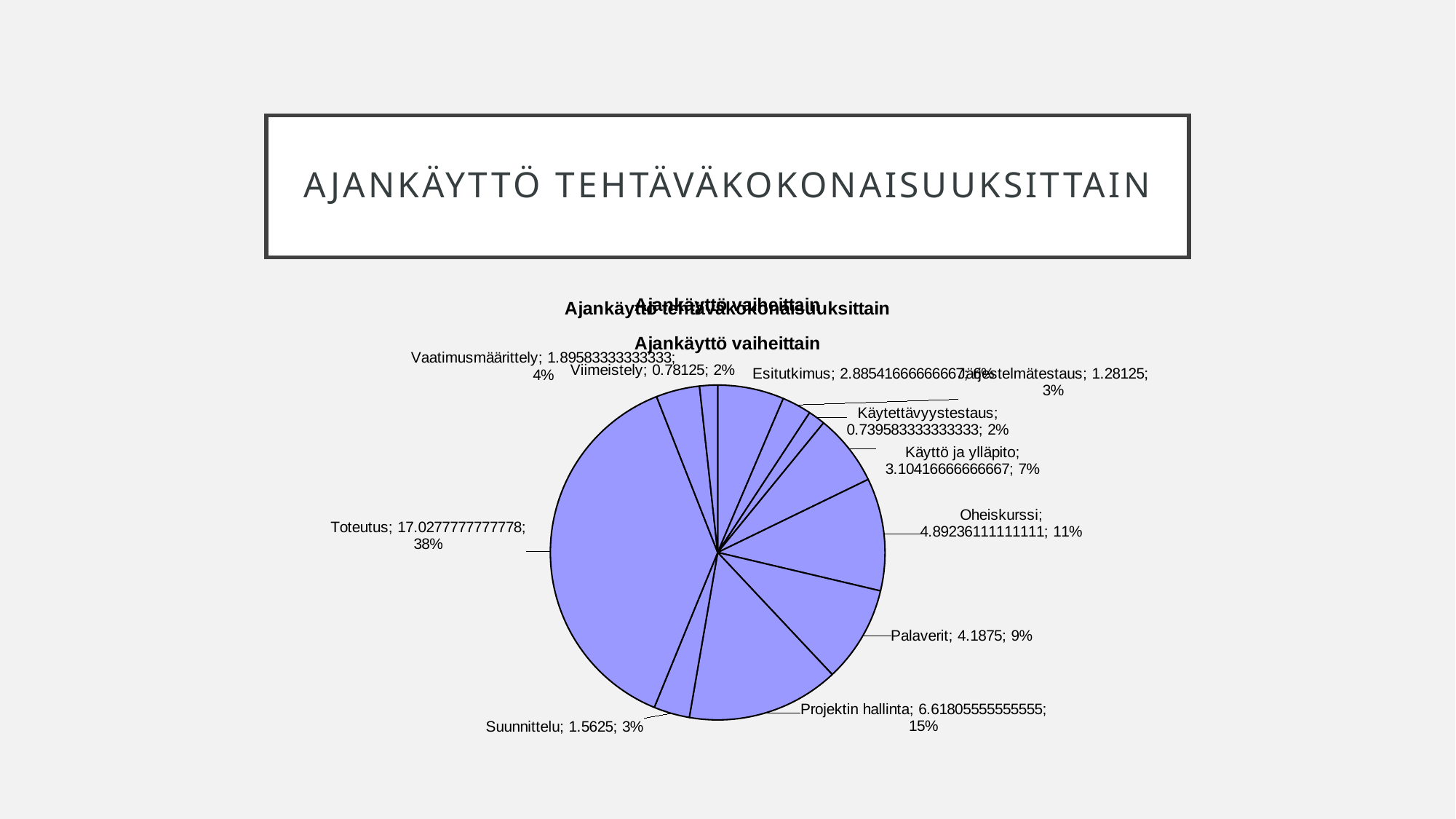
What kind of chart is shown on the slide? pie chart What share of the pie does Toteutus represent? 38% Which category has the largest slice in the pie chart? Toteutus What value is shown for Viimeistely in the pie chart? 0.78125 What share of the pie does Projektin hallinta represent? 15% Which is larger, the value for Oheiskurssi or the value for Käyttö ja ylläpito? Oheiskurssi What value is shown for Toteutus in the pie chart? 17.0277777777778 What value is shown for Suunnittelu in the pie chart? 1.5625 What value is shown for Palaverit in the pie chart? 4.1875 What is the difference between the values for Palaverit and Suunnittelu? 2.625 What share of the pie does Oheiskurssi represent? 11% Which category has the smallest slice in the pie chart? Käytettävyystestaus